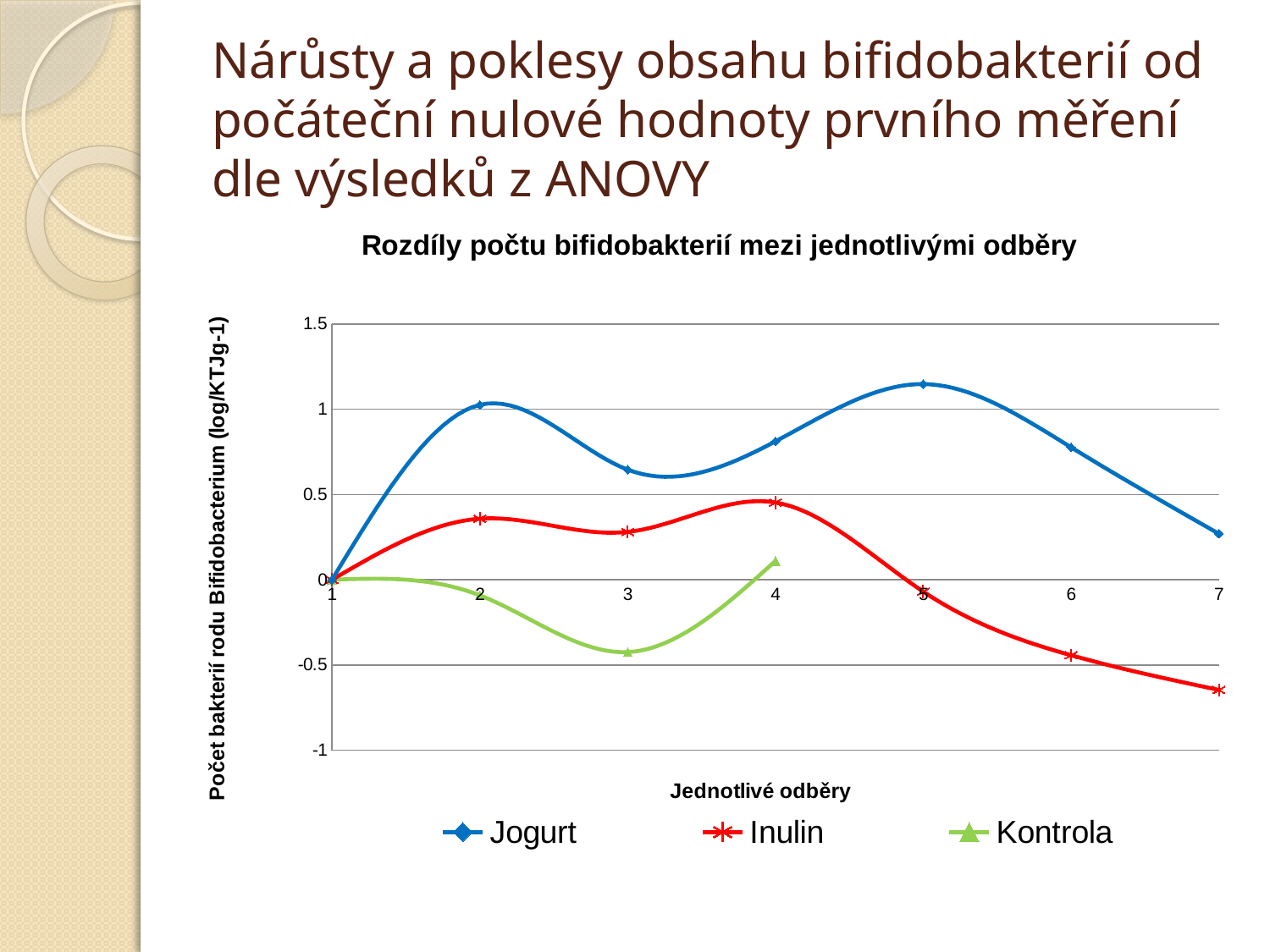
At which odběr does the Inulin series reach its lowest value? 7 How many series does the legend list? 3 What is the value for Jogurt at odběr 1? 0 Is the value for Inulin at odběr 7 greater or less than -0.5? less Is the value for Kontrola at odběr 3 greater or less than 0? less What kind of chart is shown on the slide? line chart Does the Inulin series rise or fall from odběr 4 to odběr 7? fall At odběr 3, which series has the larger value, Jogurt or Inulin? Jogurt Is the value for Jogurt at odběr 7 greater or less than 0.5? less At which odběr does the Jogurt series reach its highest value? 5 How many sampling points (odběry) are shown on the x axis? 7